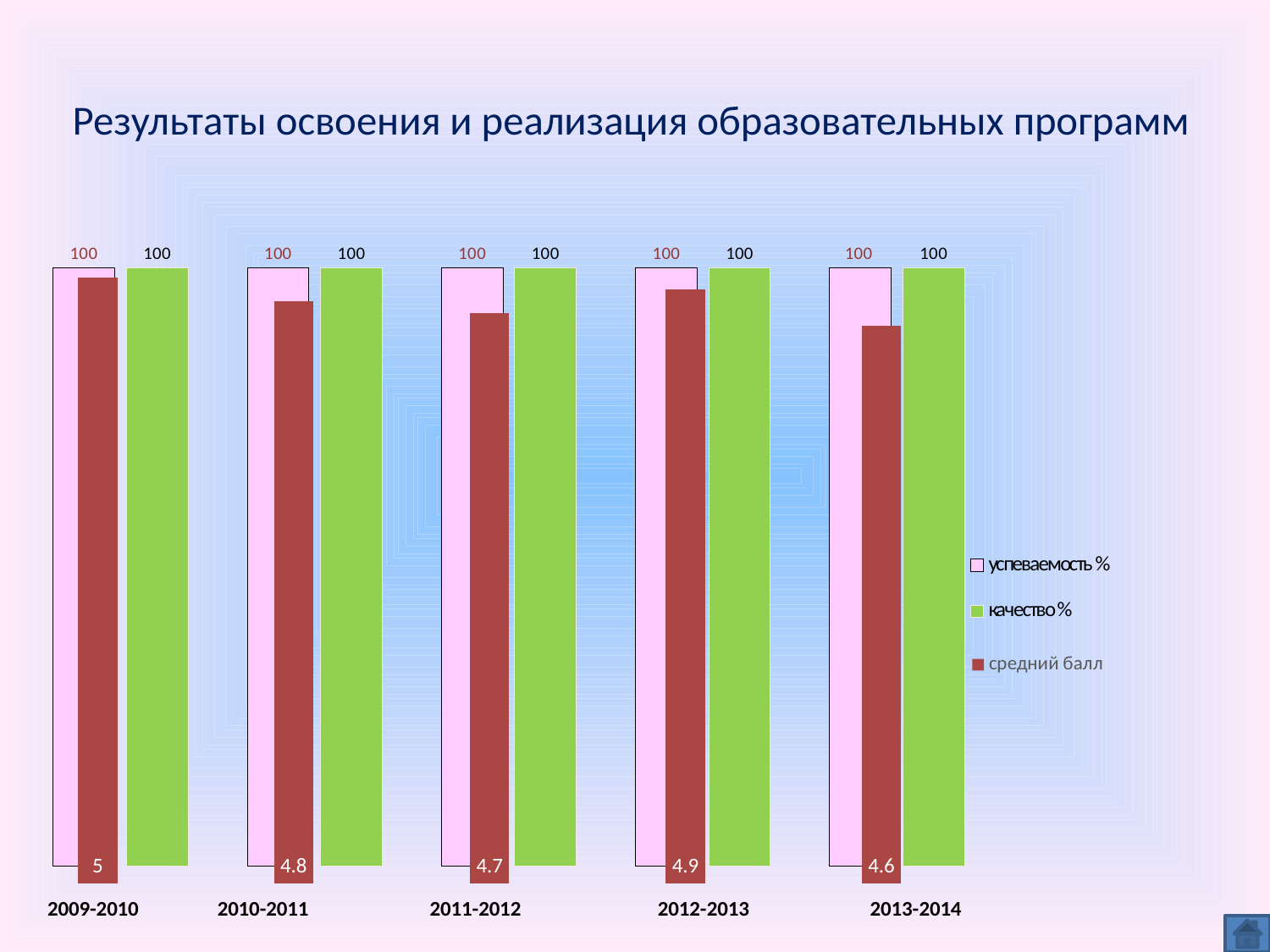
What is the value of качество % for 2010-2011? 100 What is the value of успеваемость % for 2012-2013? 100 Which is larger, the средний балл for 2010-2011 or for 2011-2012? 2010-2011 Which academic year has the highest средний балл? 2009-2010 How many series does the legend list? 3 What is the value of средний балл for 2013-2014? 4.6 How many academic years are shown on the x axis? 5 What kind of chart is shown on the slide? bar chart What is the difference between the средний балл for 2012-2013 and 2013-2014? 0.3 Which academic year has the lowest средний балл? 2013-2014 What is the value of средний балл for 2009-2010? 5 What is the value of средний балл for 2011-2012? 4.7